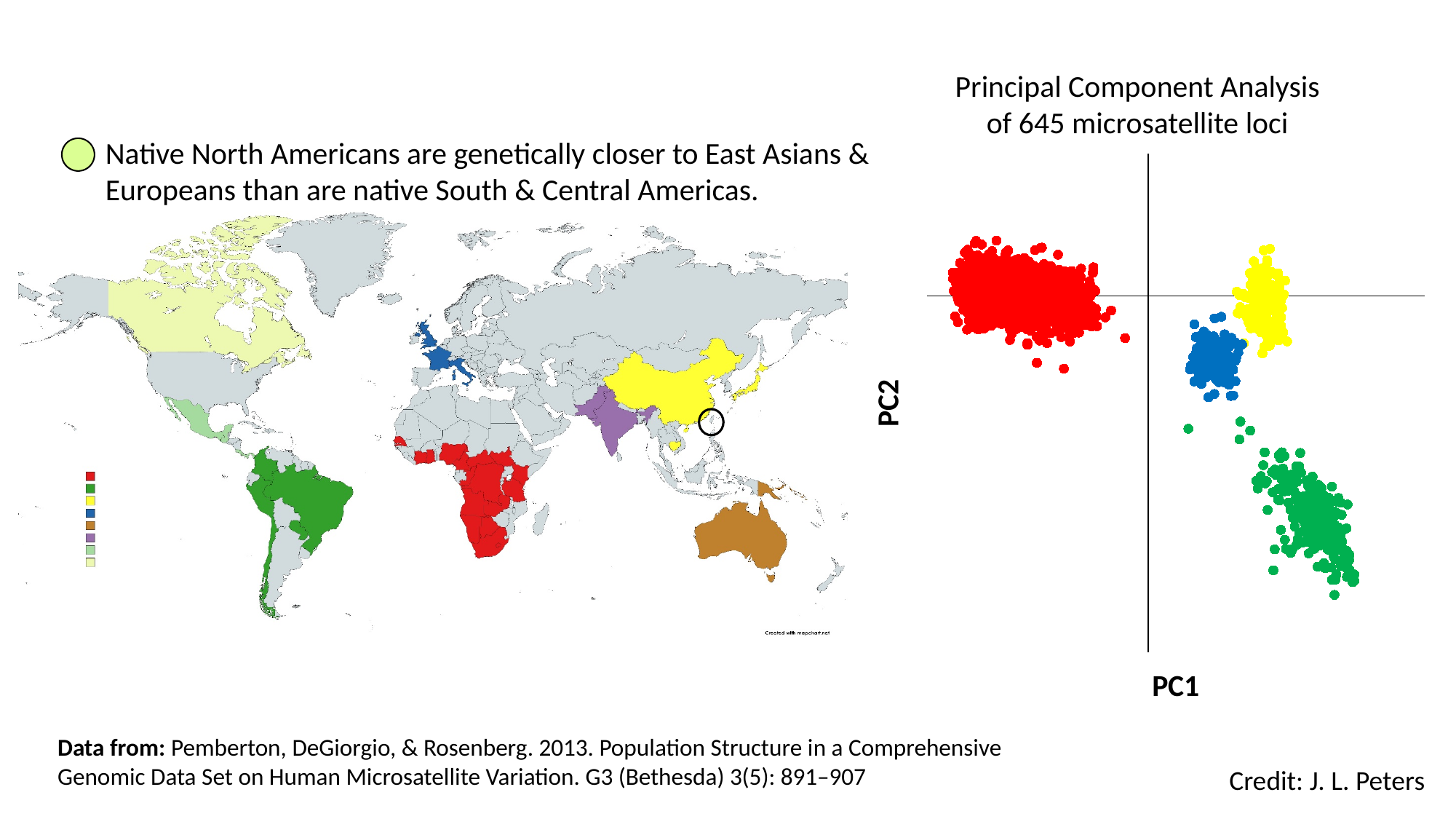
What kind of chart is the Principal Component Analysis plot on the right of the slide? scatter plot What is the title of the scatter plot on the right of the slide? Principal Component Analysis of 645 microsatellite loci In the Principal Component Analysis plot, which colour cluster extends furthest to the right along PC1? green In the Principal Component Analysis plot, which colour cluster has the lowest PC2 values? green In the Principal Component Analysis plot, what are the labels of the horizontal and vertical axes? PC1 (horizontal) and PC2 (vertical) In the Principal Component Analysis plot, which cluster has higher PC2 values, the blue cluster or the green cluster? blue In the Principal Component Analysis plot, which cluster has higher PC2 values, the yellow cluster or the blue cluster? yellow In the Principal Component Analysis plot, which cluster has higher PC1 values, the red cluster or the green cluster? green How many distinct colour clusters of points are shown in the Principal Component Analysis plot? 4 In the Principal Component Analysis plot, which colour cluster lies entirely to the left of the vertical PC2 axis? red